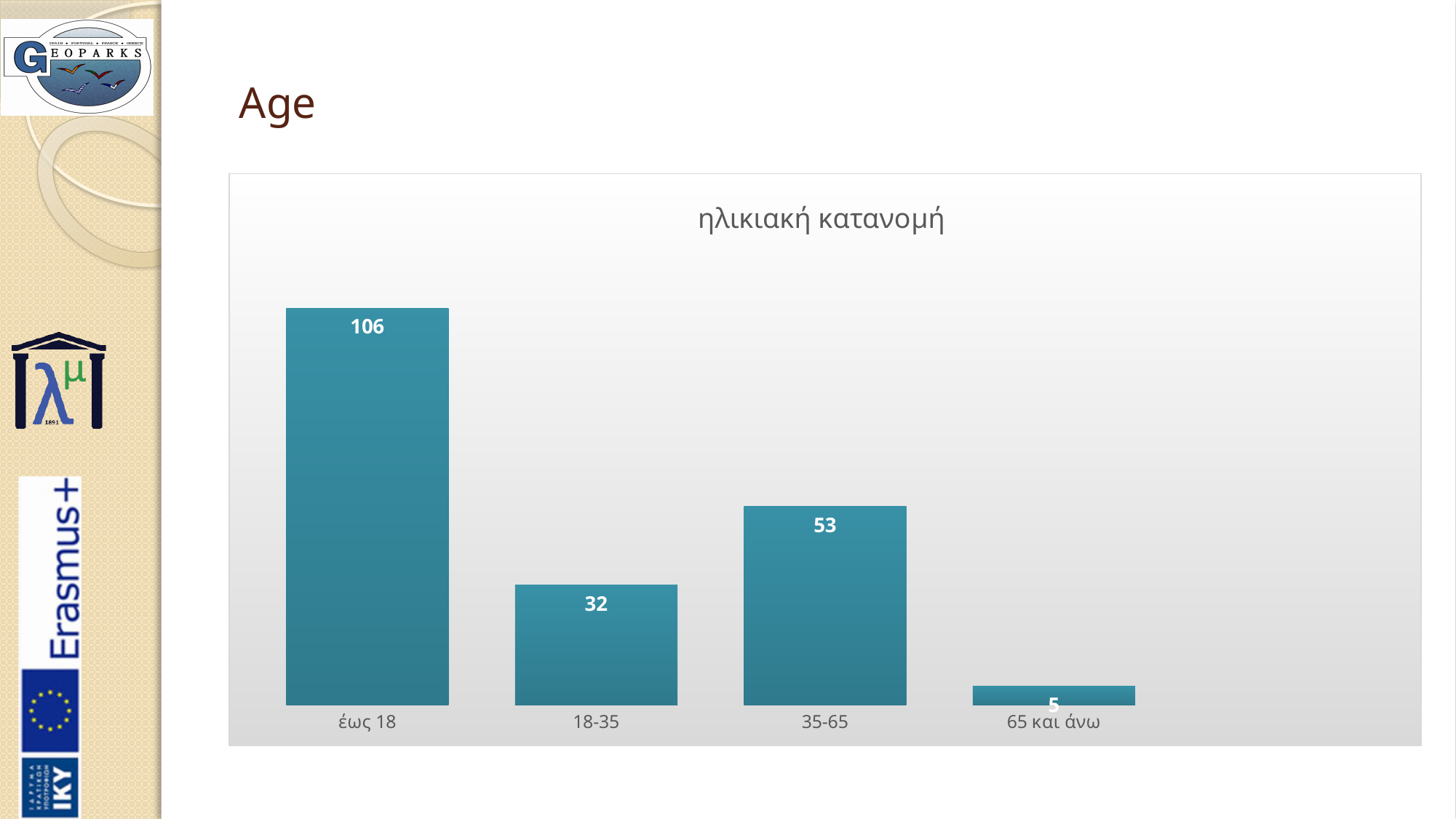
How many categories are shown in the chart? 4 What is the value for the '65 και άνω' category? 5 Which category has the highest value? έως 18 Which category has the lowest value? 65 και άνω What kind of chart is shown on the slide? bar chart What is the title of the chart? ηλικιακή κατανομή Which is larger, the value for '18-35' or the value for '35-65'? 35-65 What is the value for the 'έως 18' category? 106 What is the value for the '35-65' category? 53 What is the difference between the values for '35-65' and '18-35'? 21 What is the difference between the values for 'έως 18' and '35-65'? 53 What is the value for the '18-35' category? 32